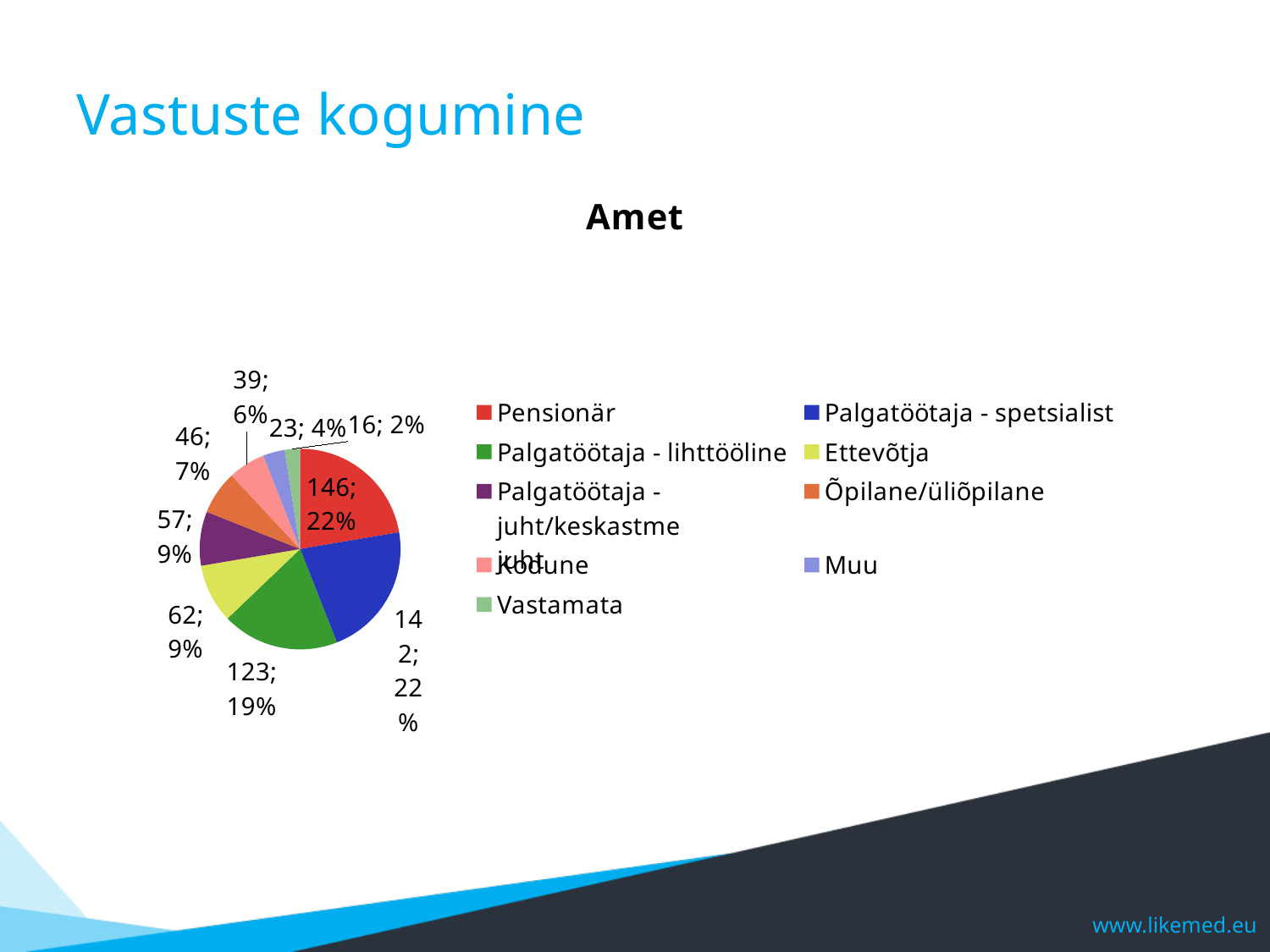
What percentage share does Kodune have? 6% Which category has the smallest slice? Vastamata What is the count shown for Palgatöötaja - juht/keskastme juht? 57 What kind of chart is shown on the slide? pie chart What is the difference between the counts for Pensionär and Palgatöötaja - lihttööline? 23 What is the count shown for Ettevõtja? 62 Which category has the largest slice? Pensionär What is the count shown for Pensionär? 146 What is the title of the chart? Amet How many categories does the legend of the chart list? 9 Which is larger, the count for Õpilane/üliõpilane or the count for Muu? Õpilane/üliõpilane What percentage share does Palgatöötaja - lihttööline have? 19%